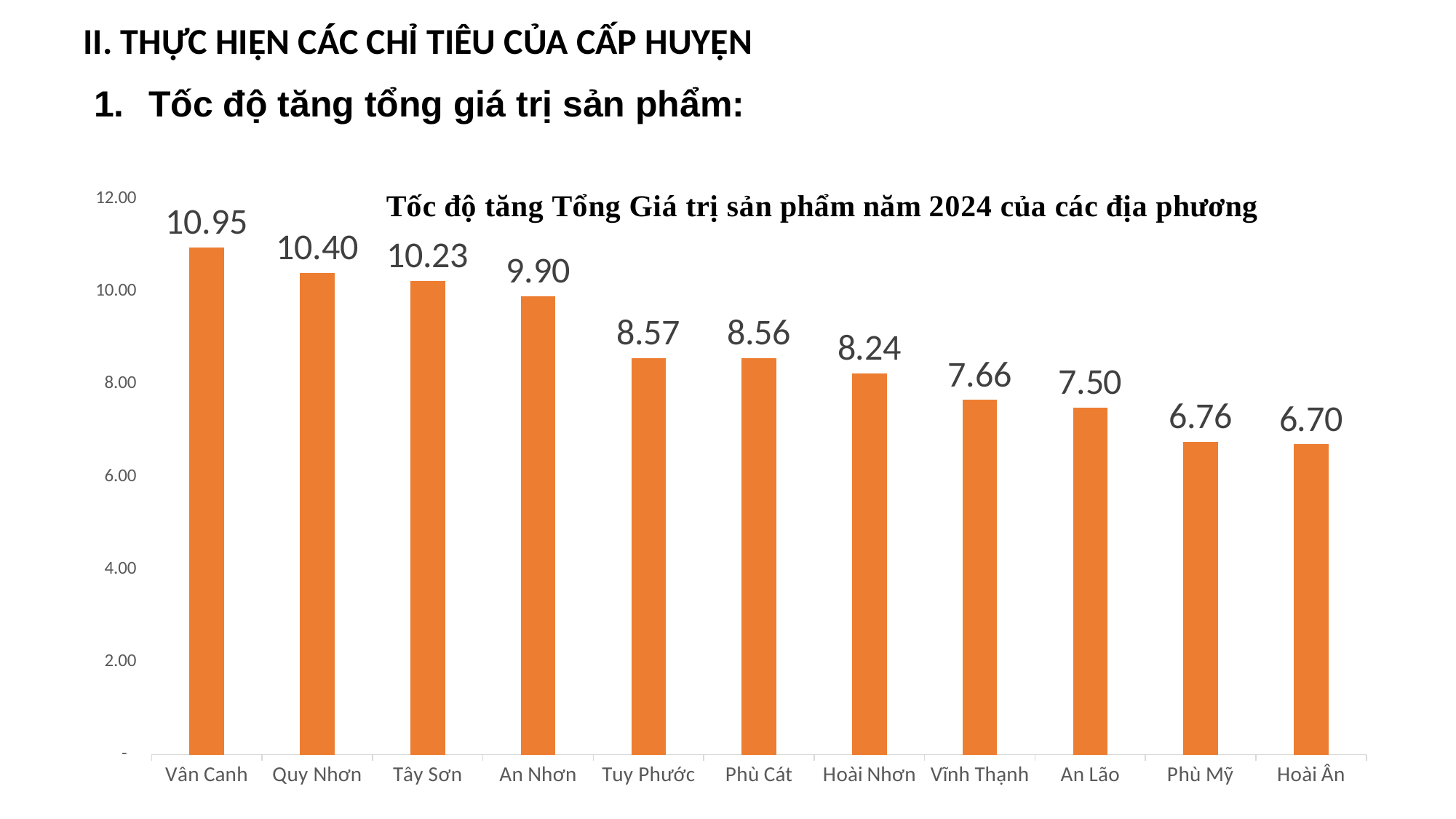
What is the value for Hoài Nhơn? 8.24 What kind of chart is shown on the slide? bar chart Which locality has the lowest value? Hoài Ân How many localities are shown on the chart? 11 Is the value for Phù Mỹ greater or less than 8.00? less Which locality has the highest value? Vân Canh Which is larger, the value for An Nhơn or the value for Vĩnh Thạnh? An Nhơn What is the title of the chart? Tốc độ tăng Tổng Giá trị sản phẩm năm 2024 của các địa phương What is the difference between the values for Quy Nhơn and Tây Sơn? 0.17 What is the value for Vân Canh? 10.95 What is the difference between the values for Vân Canh and Hoài Ân? 4.25 What is the value for An Lão? 7.50